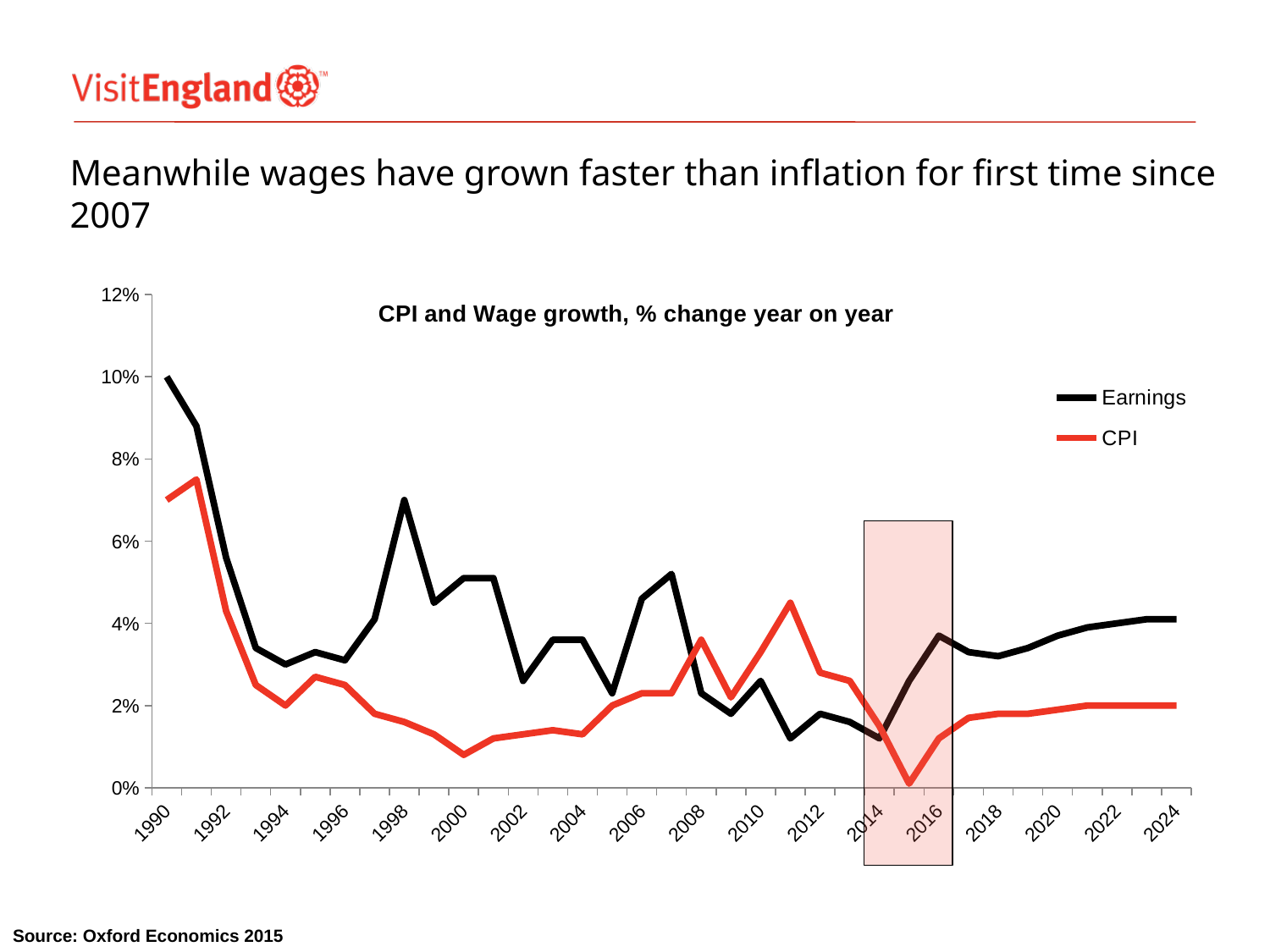
In which year does the Earnings series reach its highest value? 1990 What type of chart is shown on the slide? Line chart What colour is the CPI line? Red How many series does the legend list? 2 What is the title of the chart? CPI and Wage growth, % change year on year Is the Earnings value for 2007 greater or less than 4%? greater Does the Earnings series rise or fall between 1990 and 1994? Fall In 2024, which series is higher, Earnings or CPI? Earnings Is the Earnings value for 1998 greater or less than 6%? greater Is the CPI value for 2011 greater or less than 4%? greater In 2011, which series is higher, Earnings or CPI? CPI